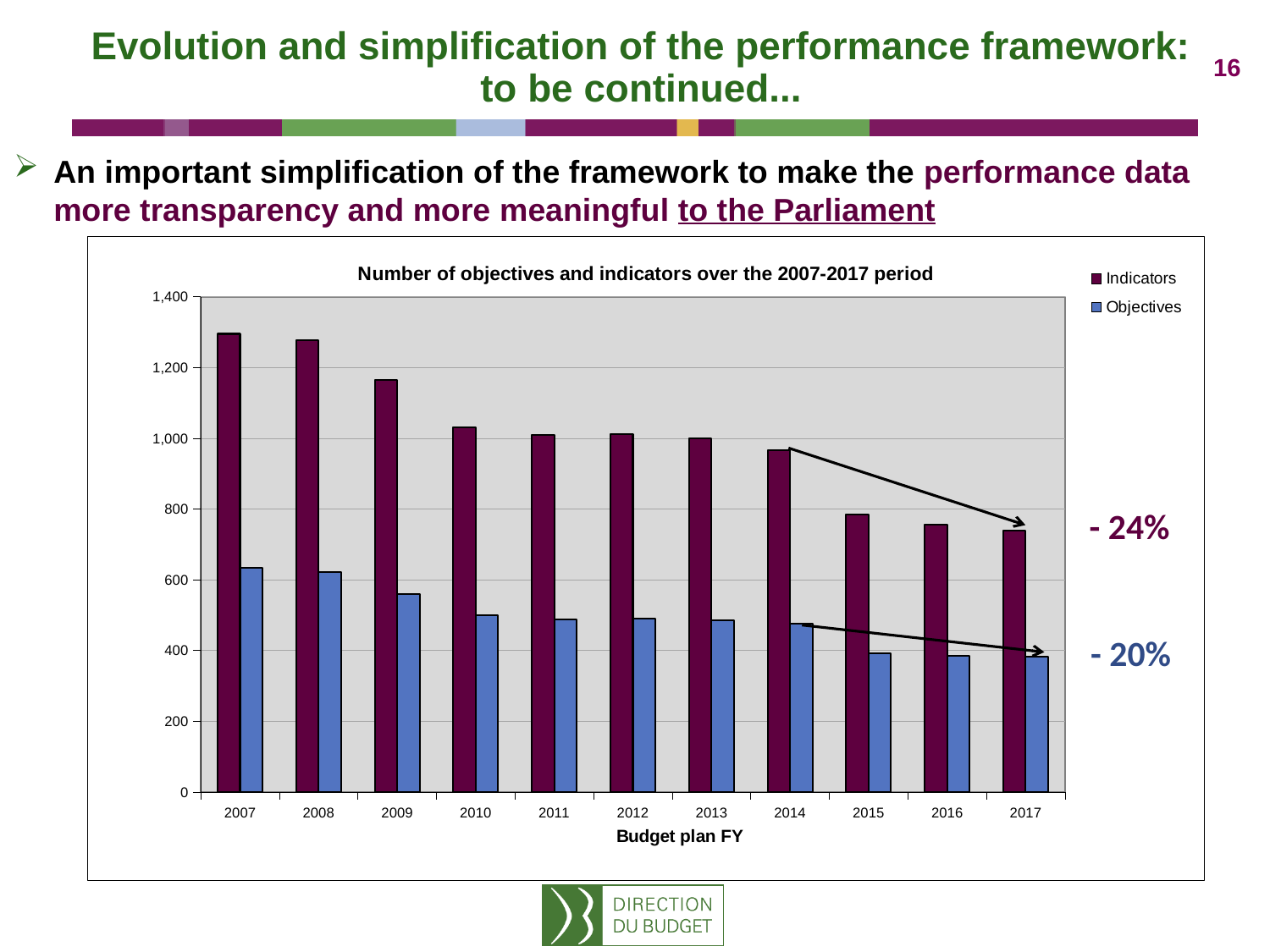
How many budget plan years are shown on the x axis? 11 Is the value for Indicators in 2007 greater or less than 1,200? greater Is the value for Objectives in 2009 greater or less than 600? less Is the value for Objectives in 2007 greater or less than 600? greater How many series does the legend list? 2 In 2012, which is larger, Indicators or Objectives? Indicators What is the title of the chart? Number of objectives and indicators over the 2007-2017 period Do the Indicators values generally rise or fall from 2007 to 2017? fall What kind of chart is shown on the slide? bar chart Which is larger, the Indicators value for 2007 or for 2015? 2007